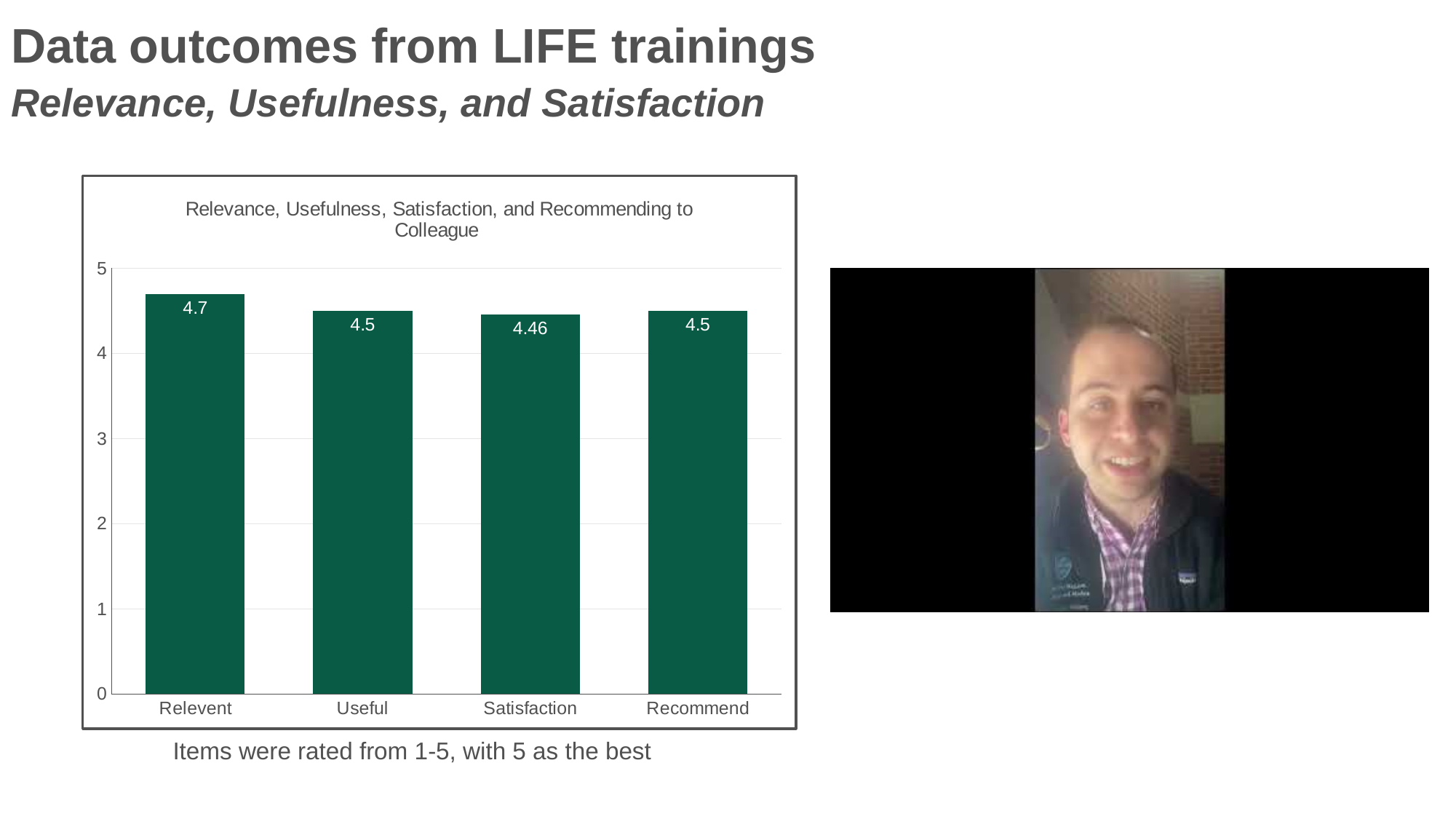
Which category has the highest value? Relevent Which category has the lowest value? Satisfaction What is the difference between the values for Relevent and Satisfaction? 0.24 What is the title of the chart? Relevance, Usefulness, Satisfaction, and Recommending to Colleague What is the value for Recommend? 4.5 What is the value for Satisfaction? 4.46 What kind of chart is shown on the slide? bar chart Which is larger, the value for Relevent or the value for Recommend? Relevent What is the value for Relevent? 4.7 How many categories are shown on the x axis? 4 What is the difference between the values for Relevent and Useful? 0.2 What is the value for Useful? 4.5